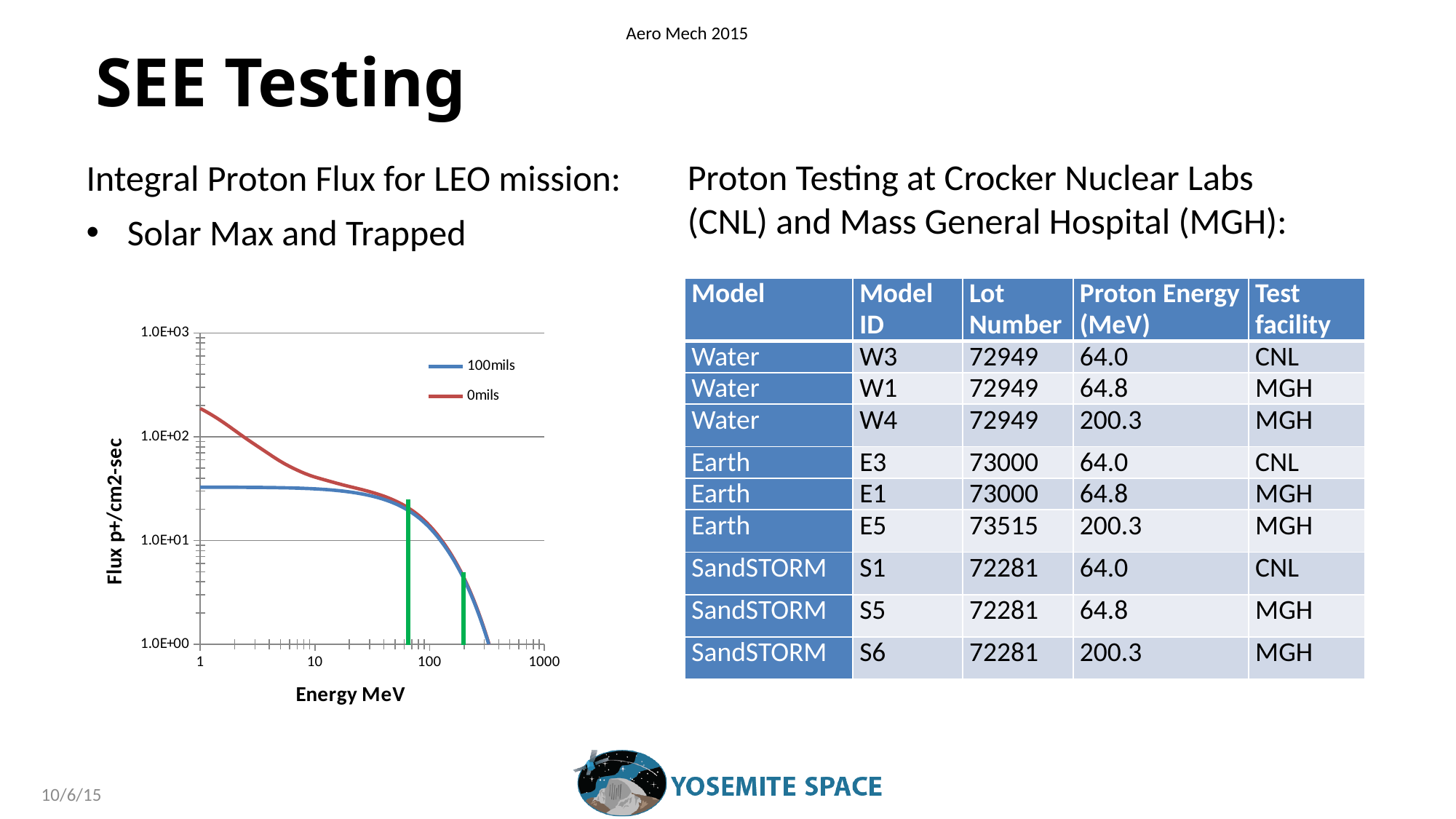
At an energy of 10 MeV, which series has the higher flux, 100mils or 0mils? 0mils How many series does the chart's legend list? 2 Which colour is used for the 0mils series in the chart? red At an energy of 1 MeV, which series has the higher flux, 100mils or 0mils? 0mils What is the title of the chart's x axis? Energy MeV At an energy of 10 MeV, is the flux for the 0mils series greater or less than 1.0E+01? greater At an energy of 1 MeV, is the flux for the 100mils series greater or less than 1.0E+02? less At an energy of 1 MeV, is the flux for the 0mils series greater or less than 1.0E+02? greater What kind of chart is shown on the slide? line chart Does the flux for the 100mils series rise or fall as energy increases along the x axis? fall Does the flux for the 0mils series rise or fall as energy increases along the x axis? fall What are the two series named in the chart's legend? 100mils and 0mils